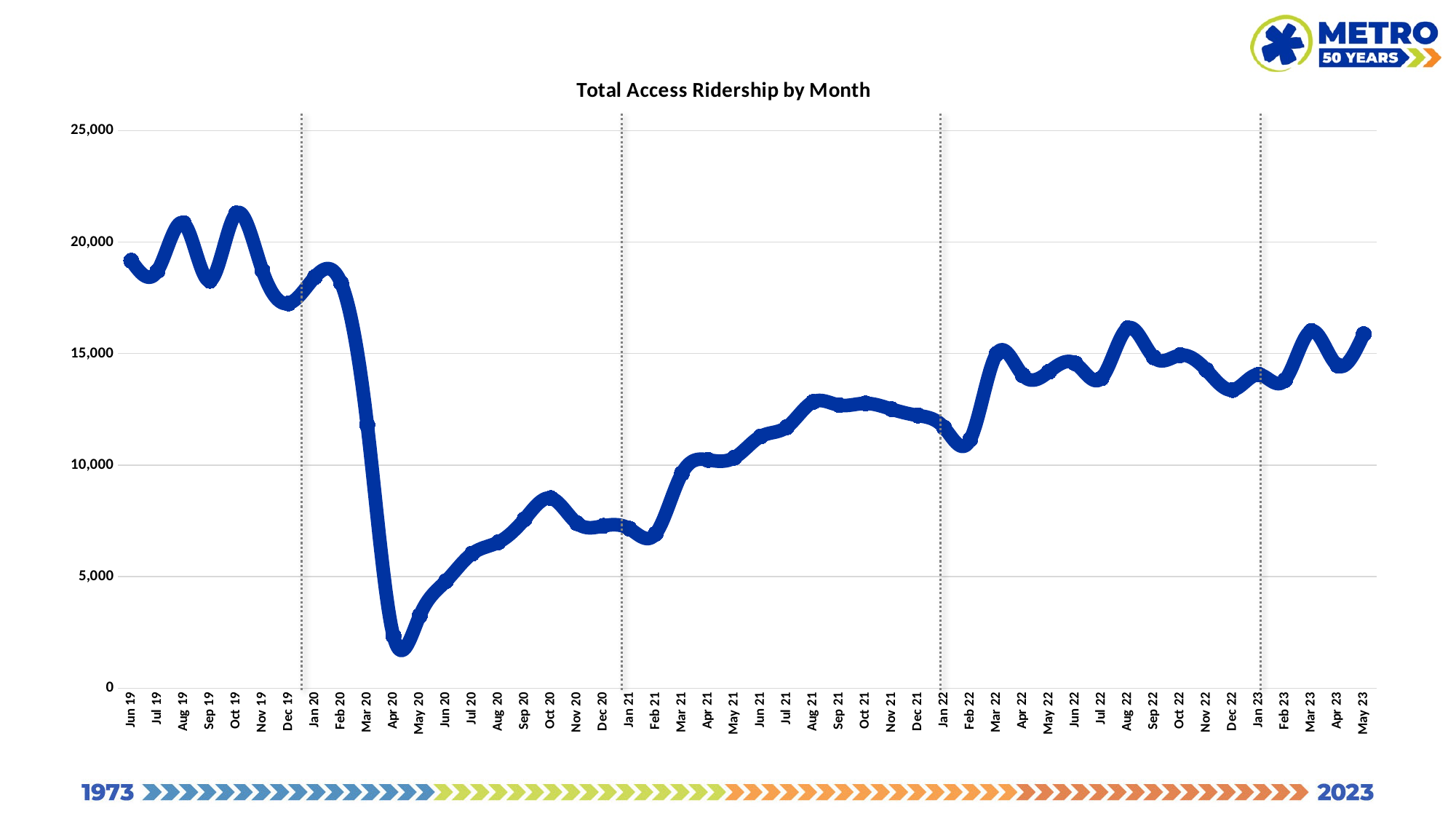
Is the value for Aug 22 greater or less than 15,000? greater Do the values rise or fall from Apr 20 to Oct 20? rise What kind of chart is shown on the slide? line chart Which month has the lowest ridership on the chart? Apr 20 Which month has the higher ridership, Aug 21 or Jan 21? Aug 21 Which month has the highest ridership on the chart? Oct 19 Is the value for Dec 22 greater or less than 15,000? less What is the title of the chart? Total Access Ridership by Month Is the value for Jan 21 greater or less than 10,000? less How many months are plotted along the x axis of the chart? 48